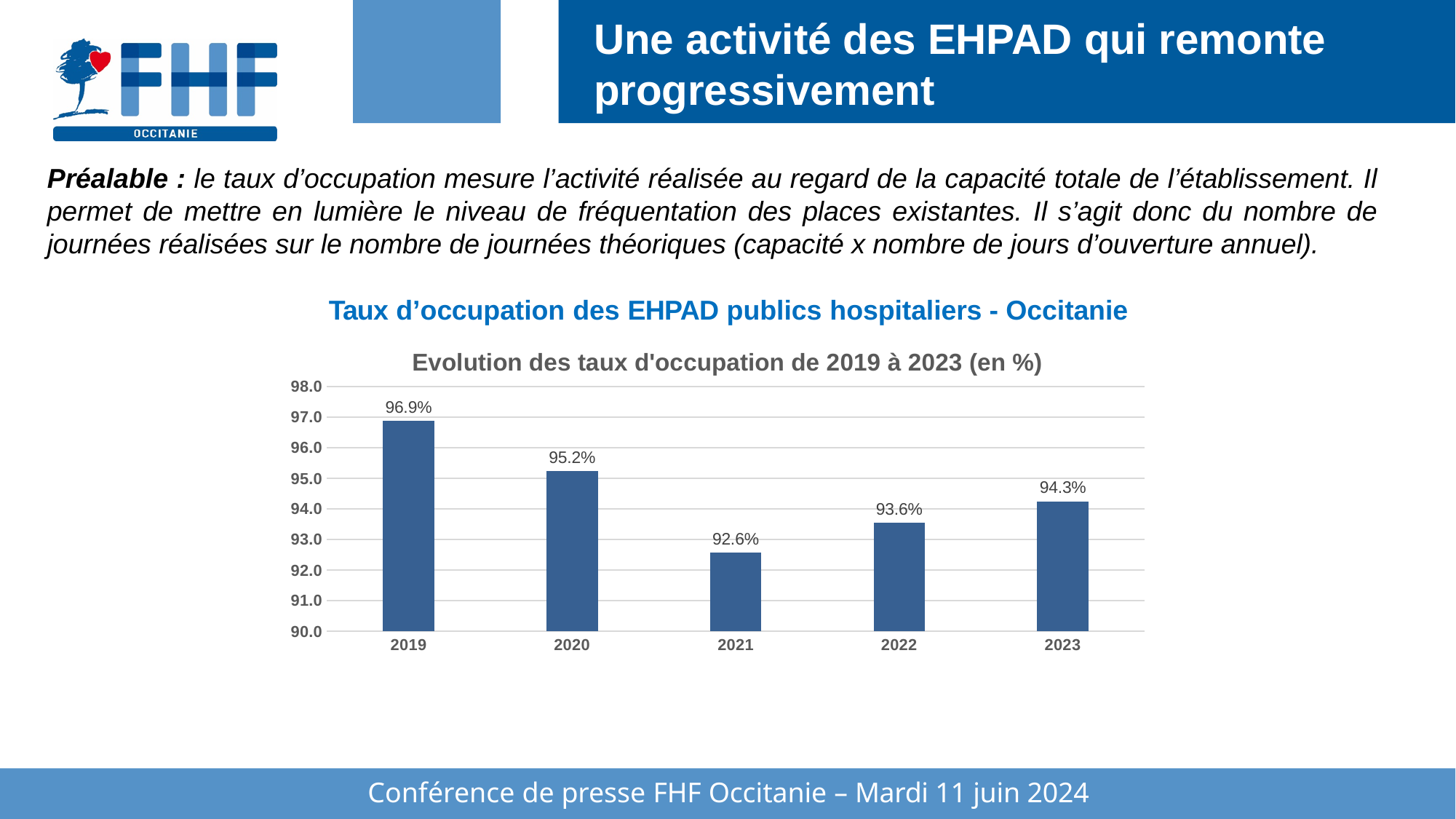
Which year has the highest occupancy rate? 2019 What is the occupancy rate shown for 2023? 94.3% What is the title of the chart? Evolution des taux d'occupation de 2019 à 2023 (en %) Which is larger, the occupancy rate for 2020 or for 2023? 2020 Is the value for 2022 greater or less than 94.0? less What kind of chart is shown on the slide? Bar chart What is the occupancy rate shown for 2021? 92.6% What is the difference between the occupancy rates for 2023 and 2022? 0.7 percentage points What is the occupancy rate shown for 2019? 96.9% Which year has the lowest occupancy rate? 2021 What is the difference between the occupancy rates for 2019 and 2021? 4.3 percentage points How many years are shown on the x axis of the chart? 5